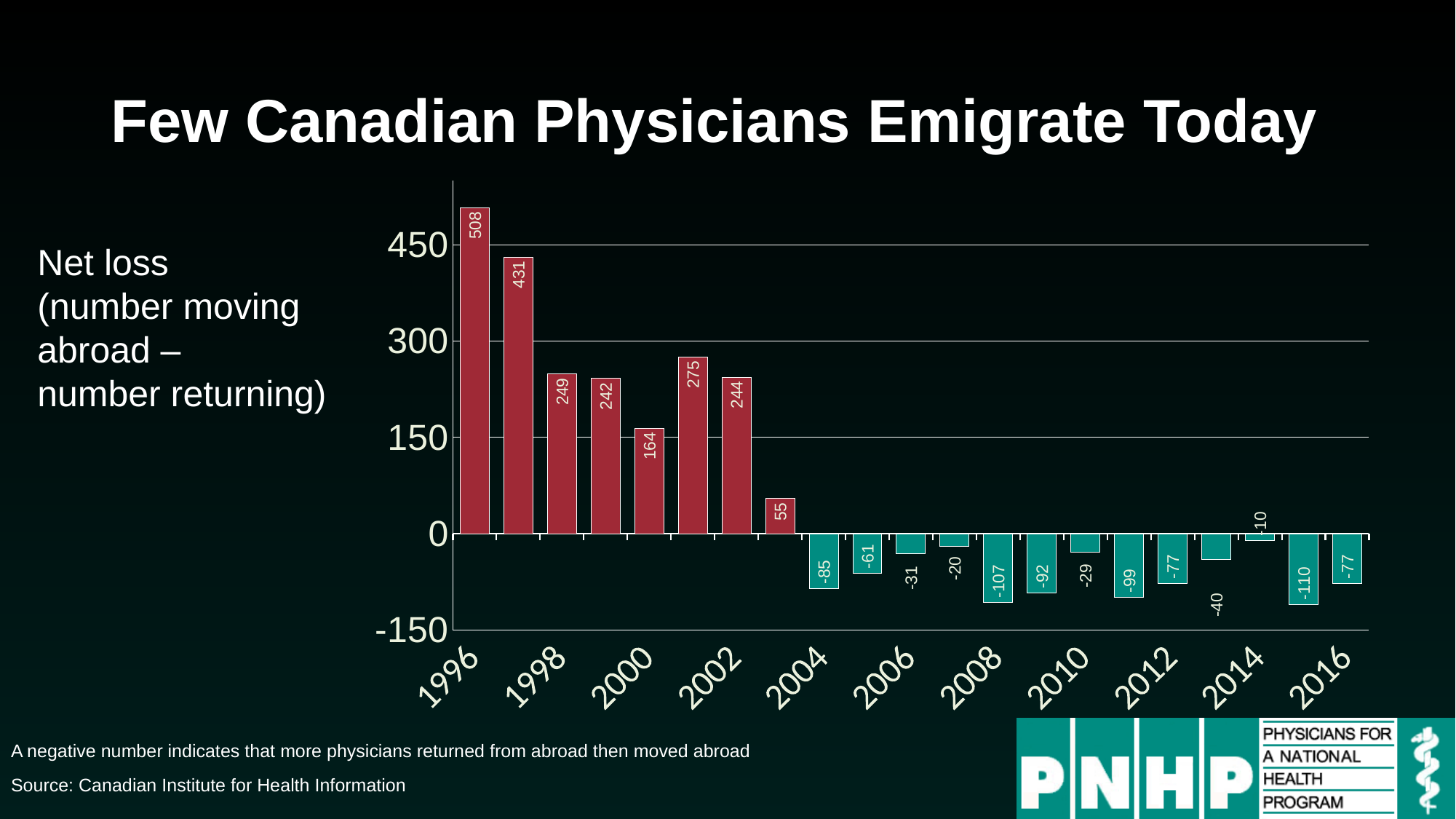
Which year has the highest net loss value? 1996 What is the value shown for 2016? -77 What is the net loss value for 2004? -85 What kind of chart is shown on the slide? bar chart How many bars are plotted on the chart? 21 What is the net loss value for 1996? 508 What is the difference between the values for 1998 and 2000? 85 Is the value for 2008 greater or less than 0? less What is the value shown for 2014? -10 What is the lowest value plotted on the chart? -110 What is the title of the slide? Few Canadian Physicians Emigrate Today Which year has the larger value, 2002 or 2006? 2002